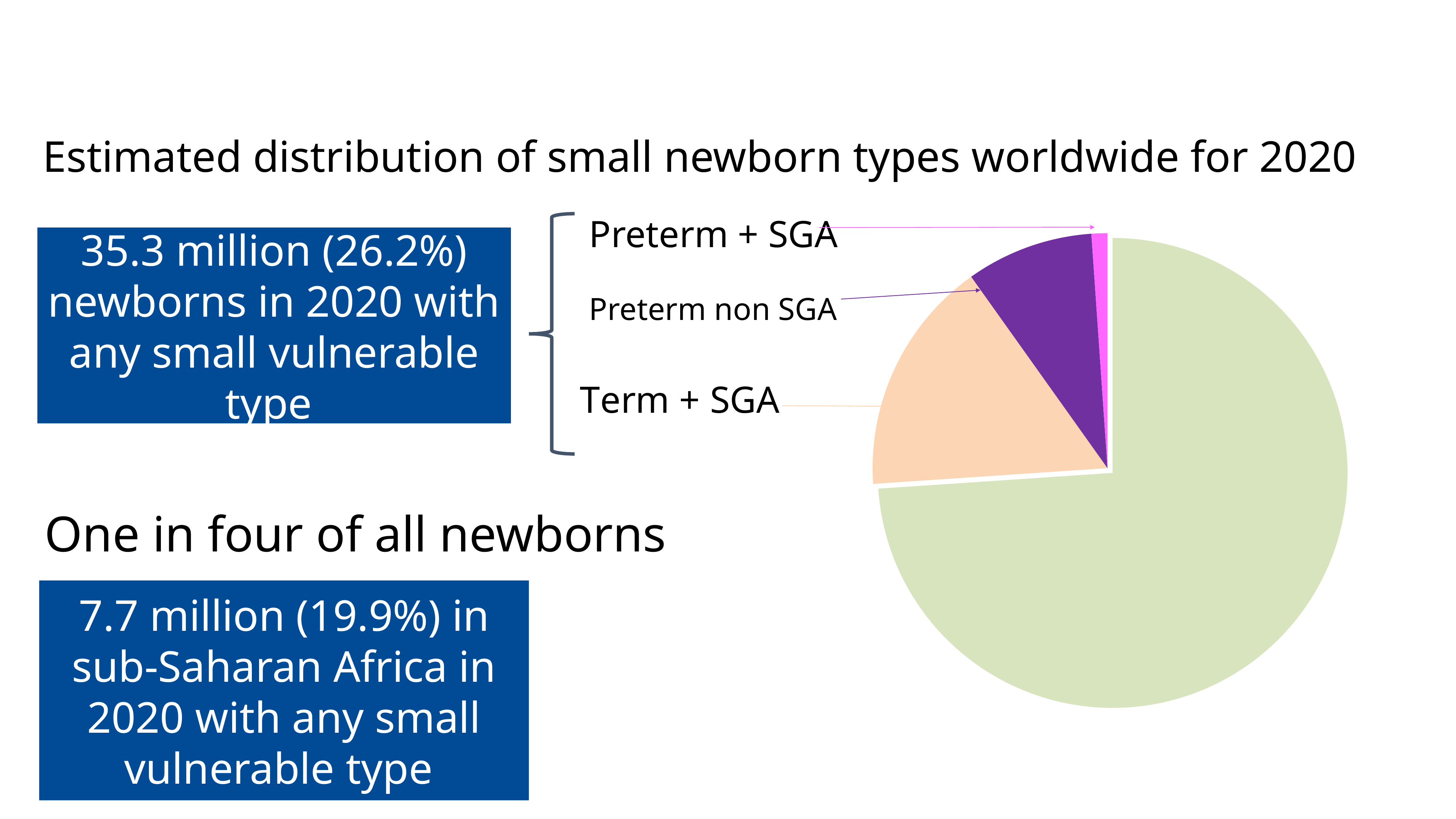
Which slice is larger, Preterm non SGA or Preterm + SGA? Preterm non SGA What colour is the Preterm non SGA slice of the pie chart? purple How many slices of the pie chart are labelled? 3 How many slices does the pie chart have in total? 4 Which slice is larger, Term + SGA or Preterm non SGA? Term + SGA According to the slide, what share of newborns in 2020 had any small vulnerable type (the three labelled slices combined)? 26.2% What is the title of the chart on the slide? Estimated distribution of small newborn types worldwide for 2020 What kind of chart is shown on the slide? pie chart According to the slide, how many newborns in 2020 had any small vulnerable type? 35.3 million According to the slide, what percentage of newborns in sub-Saharan Africa in 2020 had any small vulnerable type? 19.9% Which of the labelled slices of the pie chart is the largest? Term + SGA Which of the labelled slices of the pie chart is the smallest? Preterm + SGA